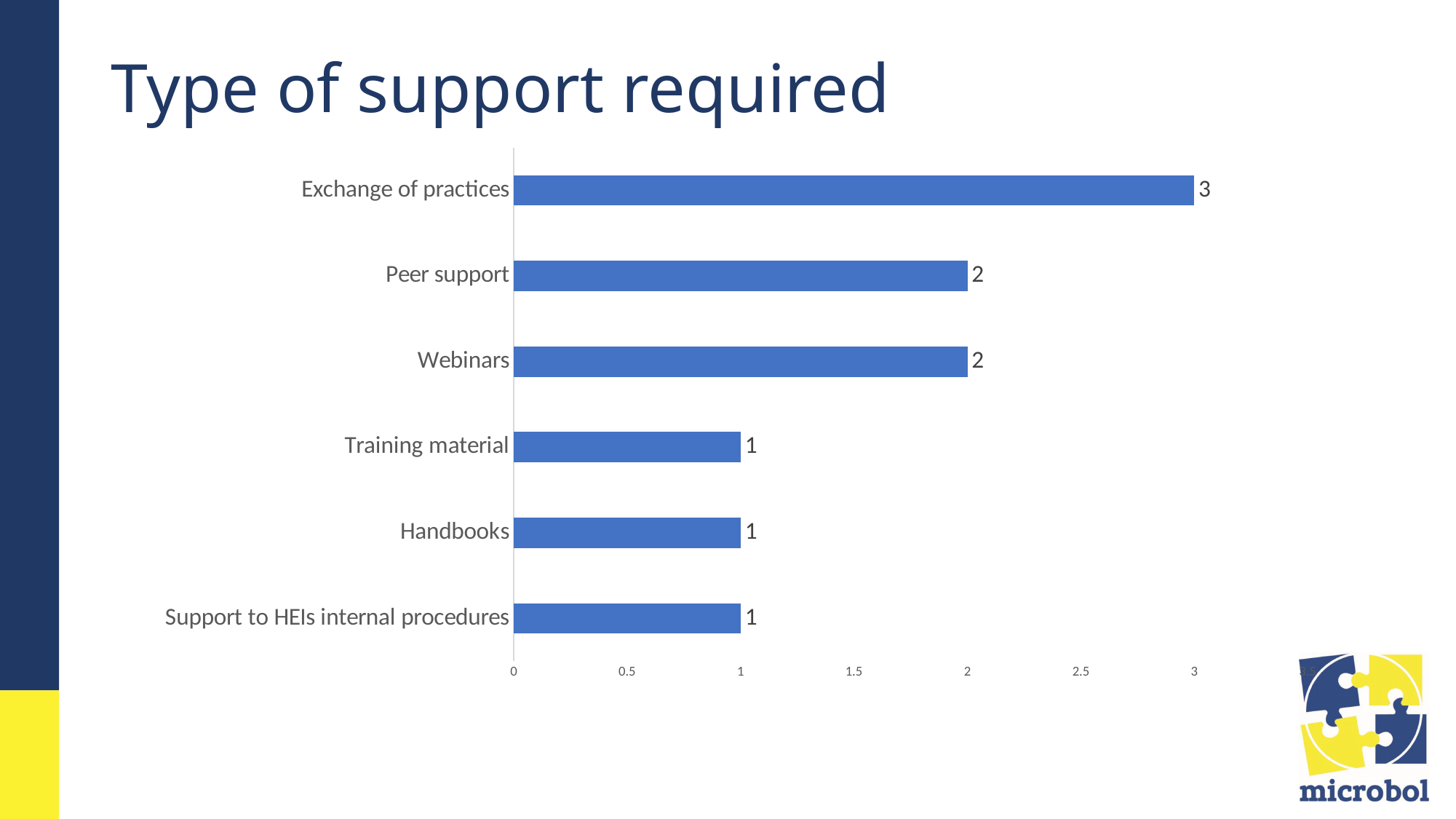
Is the value for Exchange of practices greater or less than 2.5? greater What is the value for Peer support? 2 What is the value for Training material? 1 What is the value for Support to HEIs internal procedures? 1 What is the difference between the values for Peer support and Handbooks? 1 Which category has the highest value? Exchange of practices What is the difference between the values for Exchange of practices and Webinars? 1 Which is larger, the value for Webinars or the value for Training material? Webinars How many categories are shown in the chart? 6 What is the title of the slide containing the chart? Type of support required What is the value for Exchange of practices? 3 What kind of chart is shown on the slide? bar chart